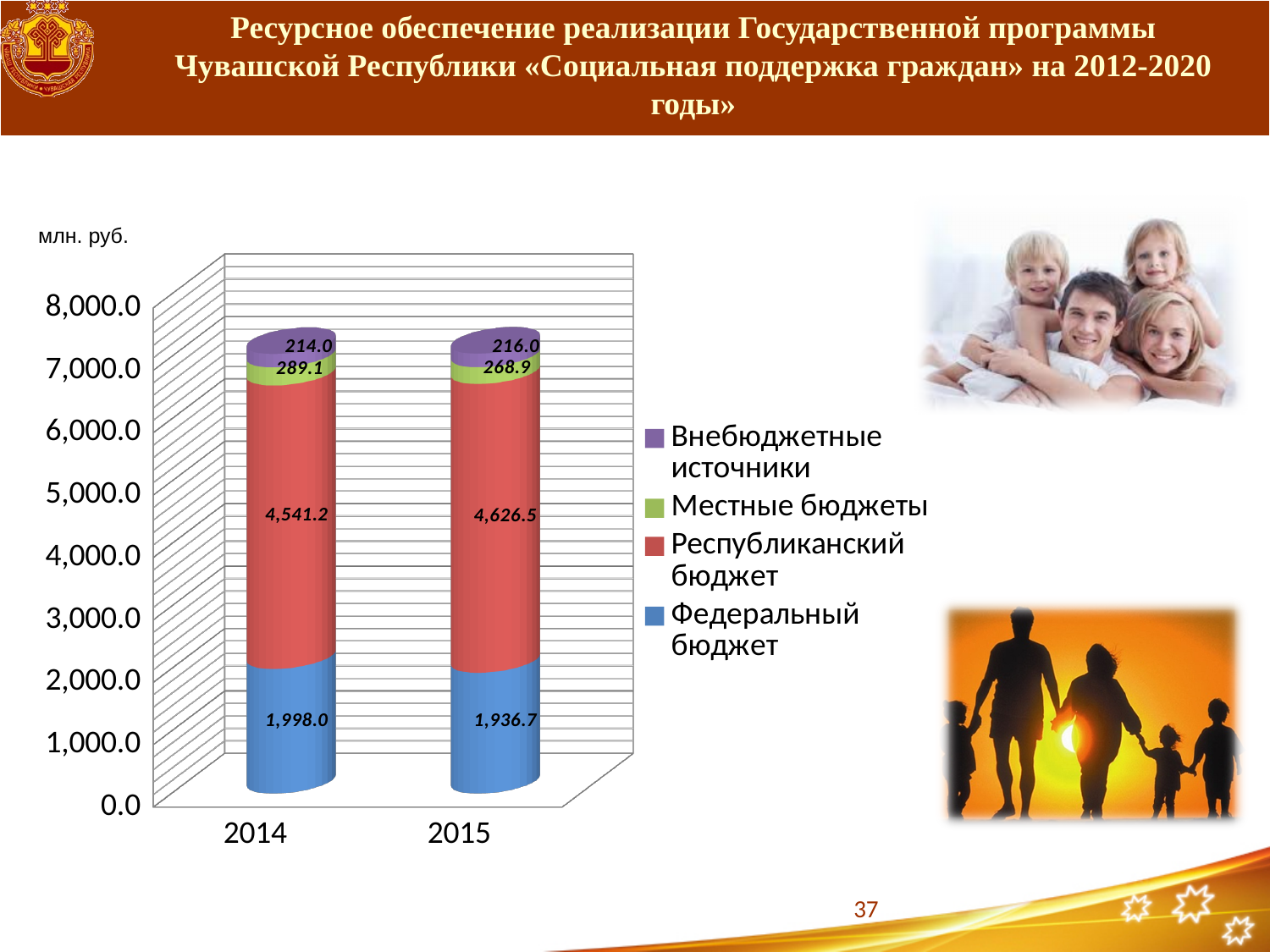
What kind of chart is shown on the slide? Stacked bar chart What is the value for Местные бюджеты in 2014? 289.1 What is the value for Федеральный бюджет in 2014? 1,998.0 How many categories are shown on the x axis? 2 How many series does the legend list? 4 Which year has the larger value for Федеральный бюджет, 2014 or 2015? 2014 What is the value for Внебюджетные источники in 2015? 216.0 Which series has the largest value in the 2015 bar? Республиканский бюджет What is the difference between the Республиканский бюджет values for 2015 and 2014? 85.3 Which series has the smallest value in the 2014 bar? Внебюджетные источники What is the total of the stacked bar for 2014? 7,042.3 What is the value for Республиканский бюджет in 2015? 4,626.5